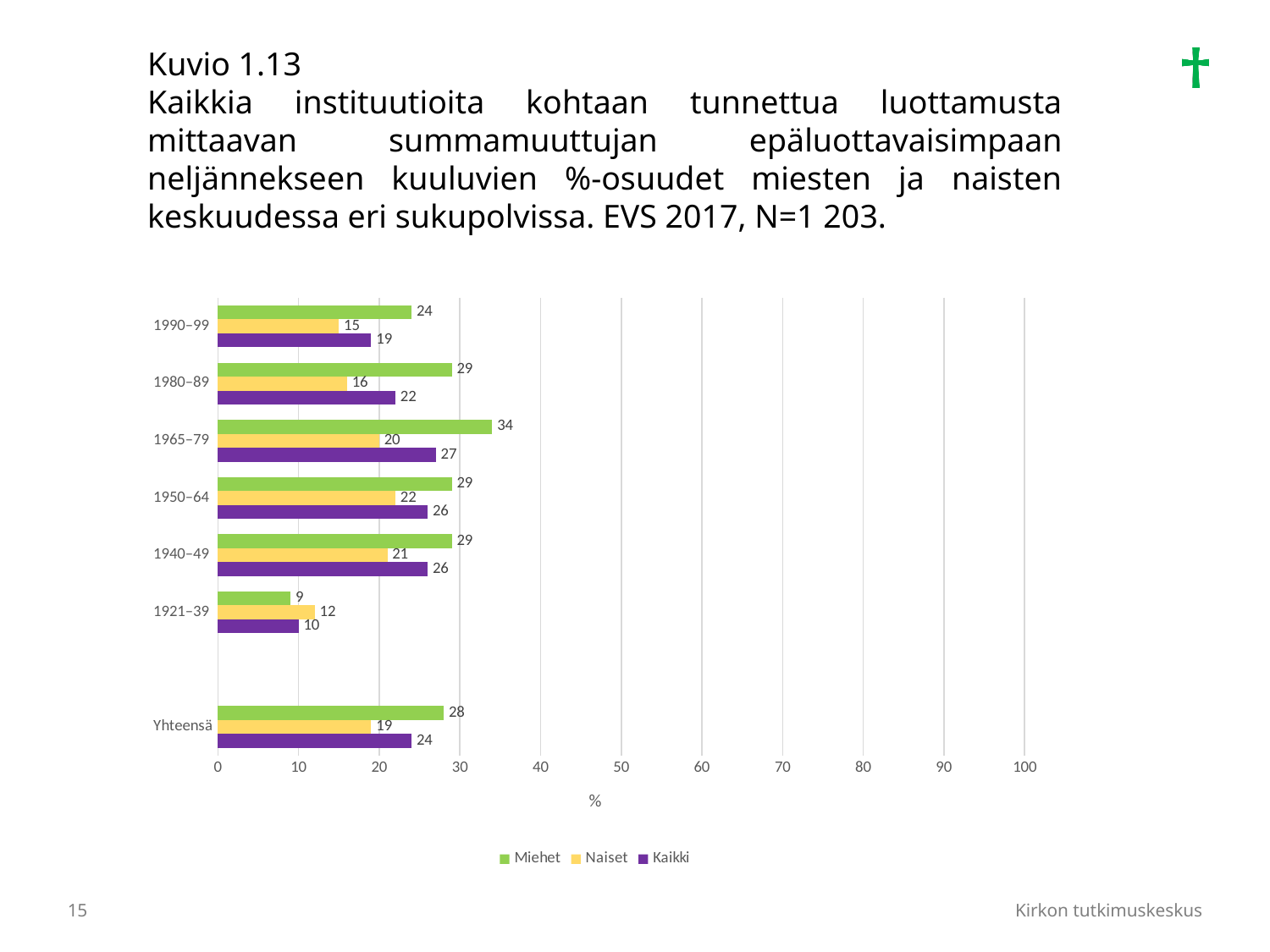
Which is larger in the 1921–39 category, the Miehet value or the Naiset value? Naiset What is the value for Kaikki in the Yhteensä category? 24 How many series does the legend list? 3 What is the label on the horizontal axis? % Which category has the highest Miehet value? 1965–79 How many categories are shown on the vertical axis? 7 What kind of chart is shown on the slide? Bar chart What is the value for Miehet in the 1965–79 category? 34 Which category has the lowest Kaikki value? 1921–39 What is the value for Naiset in the 1990–99 category? 15 Which series is shown in green? Miehet What is the difference between the Miehet and Naiset values in the 1980–89 category? 13